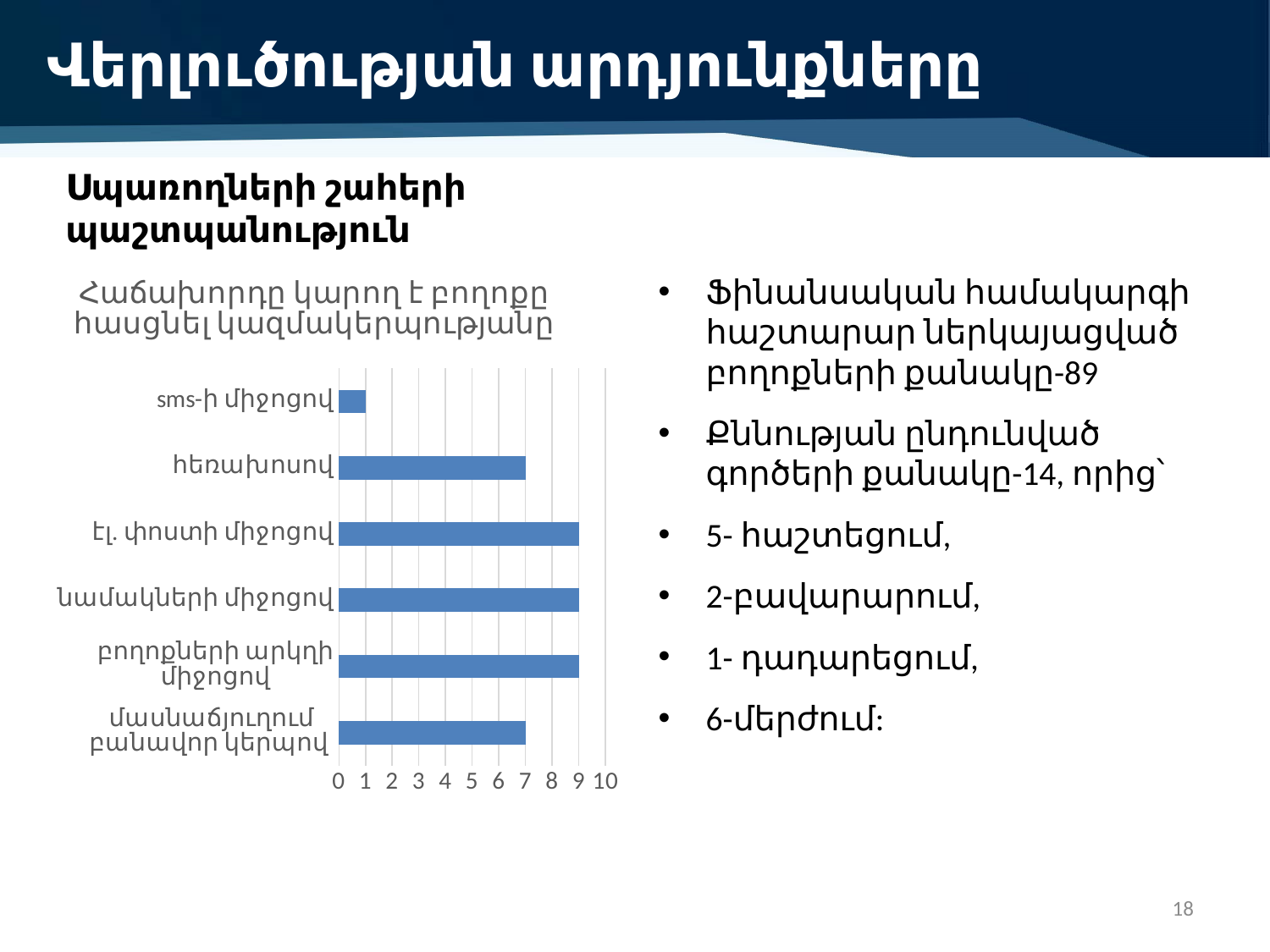
What is the value for "հեռախոսով" in the bar chart? 7 What is the value for "մասնաճյուղում բանավոր կերպով" in the bar chart? 7 Is the value for "բողոքների արկղի միջոցով" greater or less than 5? greater What is the title of the bar chart? Հաճախորդը կարող է բողոքը հասցնել կազմակերպությանը Which category has the lowest value in the bar chart? sms-ի միջոցով What is the value for "Էլ. փոստի միջոցով" in the bar chart? 9 What is the value for "sms-ի միջոցով" in the bar chart? 1 How many categories does the bar chart show? 6 What kind of chart is shown on the slide? bar chart What is the difference between the value for "Էլ. փոստի միջոցով" and the value for "հեռախոսով"? 2 Which is larger in the bar chart: the value for "նամակների միջոցով" or the value for "հեռախոսով"? նամակների միջոցով Is the value for "sms-ի միջոցով" greater or less than 5? less